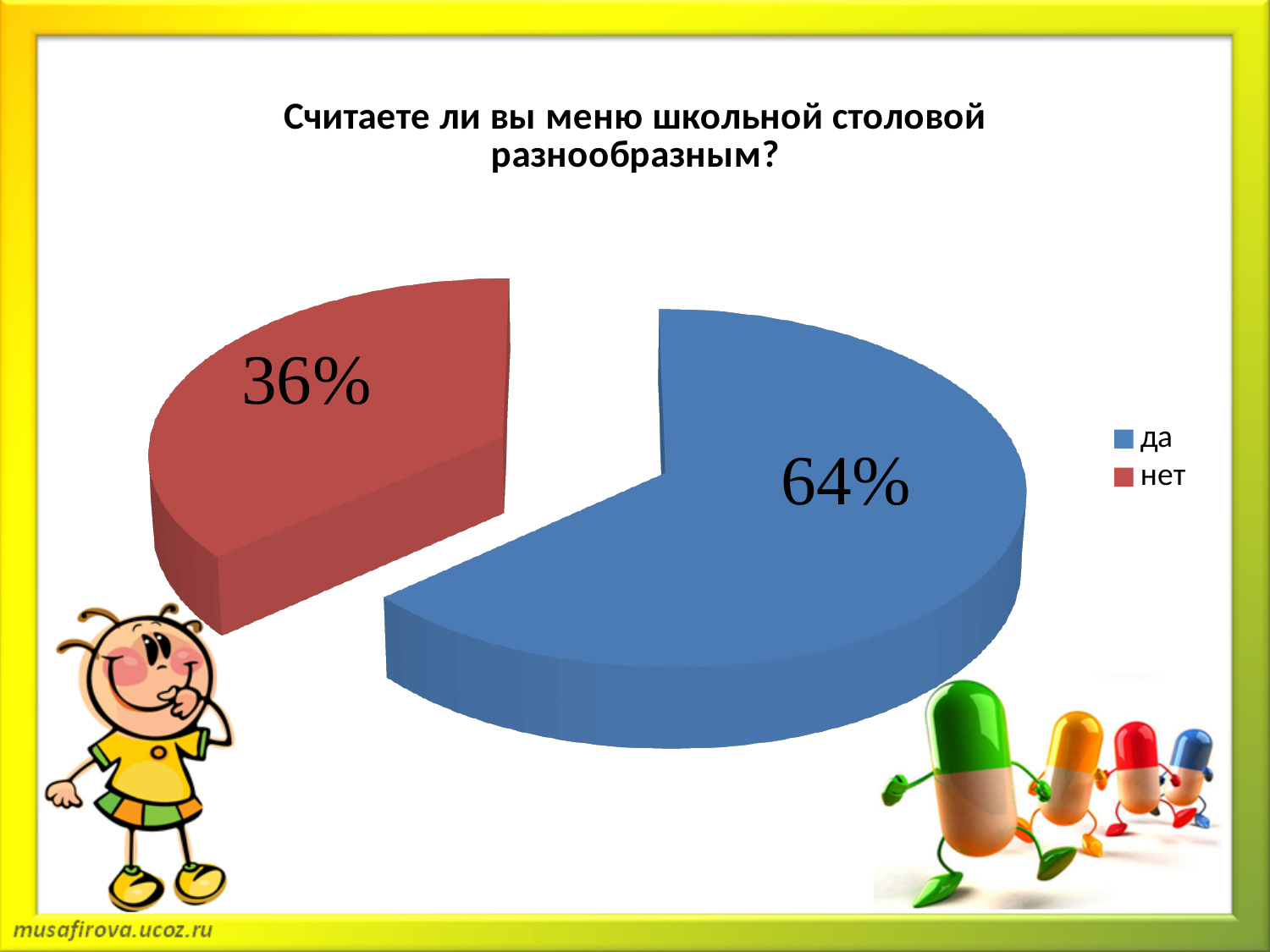
How many entries does the legend list? 2 What percentage of respondents answered "да"? 64% What percentage of respondents answered "нет"? 36% What is the title of the chart? Считаете ли вы меню школьной столовой разнообразным? How many slices does the pie chart have? 2 What colour is the "нет" slice? red Is the share for "нет" greater or less than 50%? less What is the difference in percentage points between the "да" and "нет" slices? 28 What kind of chart is shown on the slide? pie chart Which answer has the largest share of the pie? да Which answer has the smallest share of the pie? нет Which slice is larger, "да" or "нет"? да